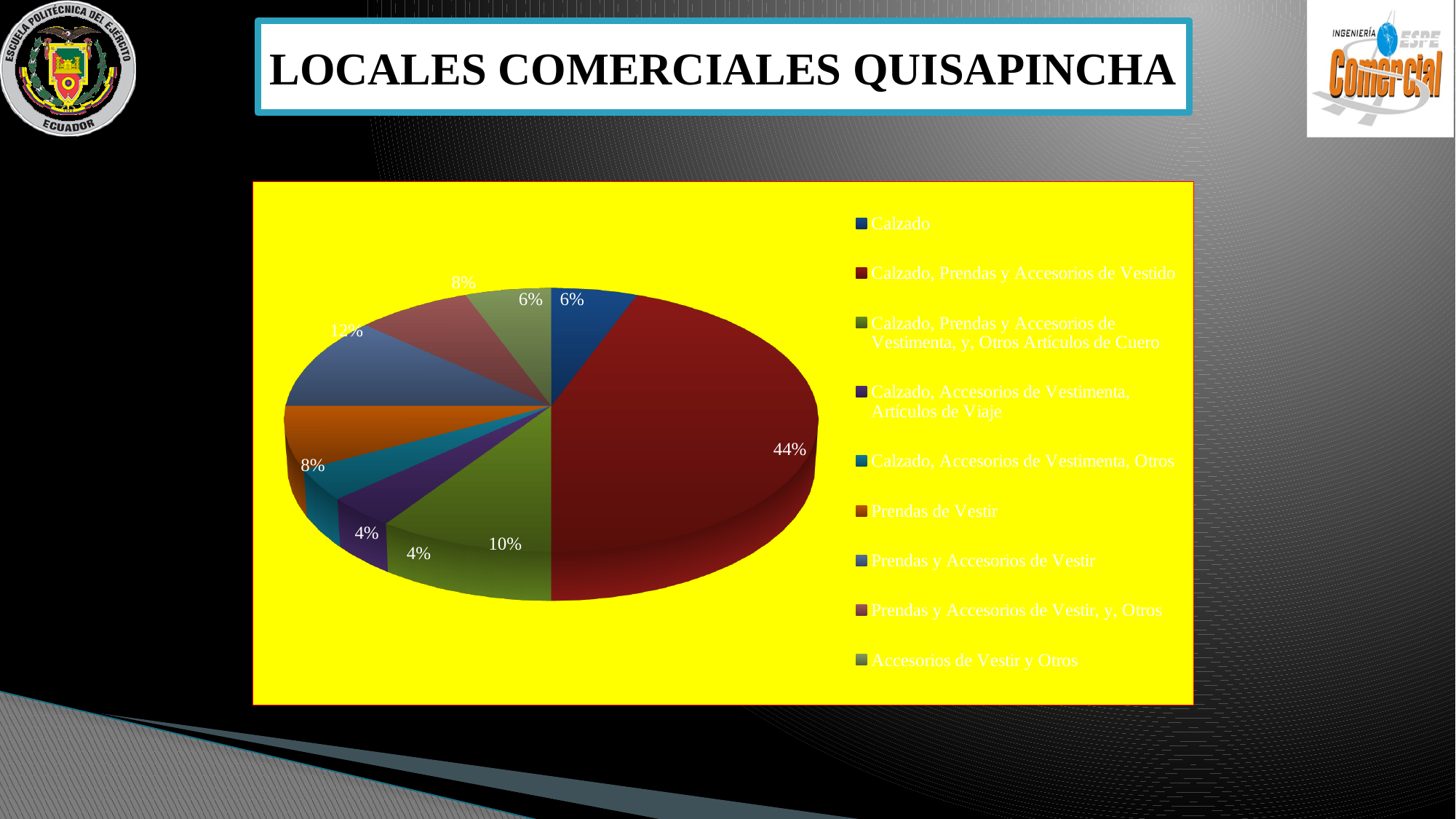
Which is larger: the slice for 'Prendas y Accesorios de Vestir' or the slice for 'Prendas de Vestir'? Prendas y Accesorios de Vestir What share of the pie does 'Calzado, Prendas y Accesorios de Vestido' represent? 44% What share of the pie does 'Calzado' represent? 6% What is the title of the slide containing the pie chart? LOCALES COMERCIALES QUISAPINCHA What share of the pie does 'Calzado, Prendas y Accesorios de Vestimenta, y, Otros Artículos de Cuero' represent? 10% What colour is the slice for 'Calzado, Prendas y Accesorios de Vestido'? dark red How many categories does the legend of the pie chart list? 9 What is the difference in percentage points between 'Calzado, Prendas y Accesorios de Vestido' and 'Prendas y Accesorios de Vestir'? 32 What kind of chart is shown on the slide? pie chart Which category has the largest slice of the pie? Calzado, Prendas y Accesorios de Vestido